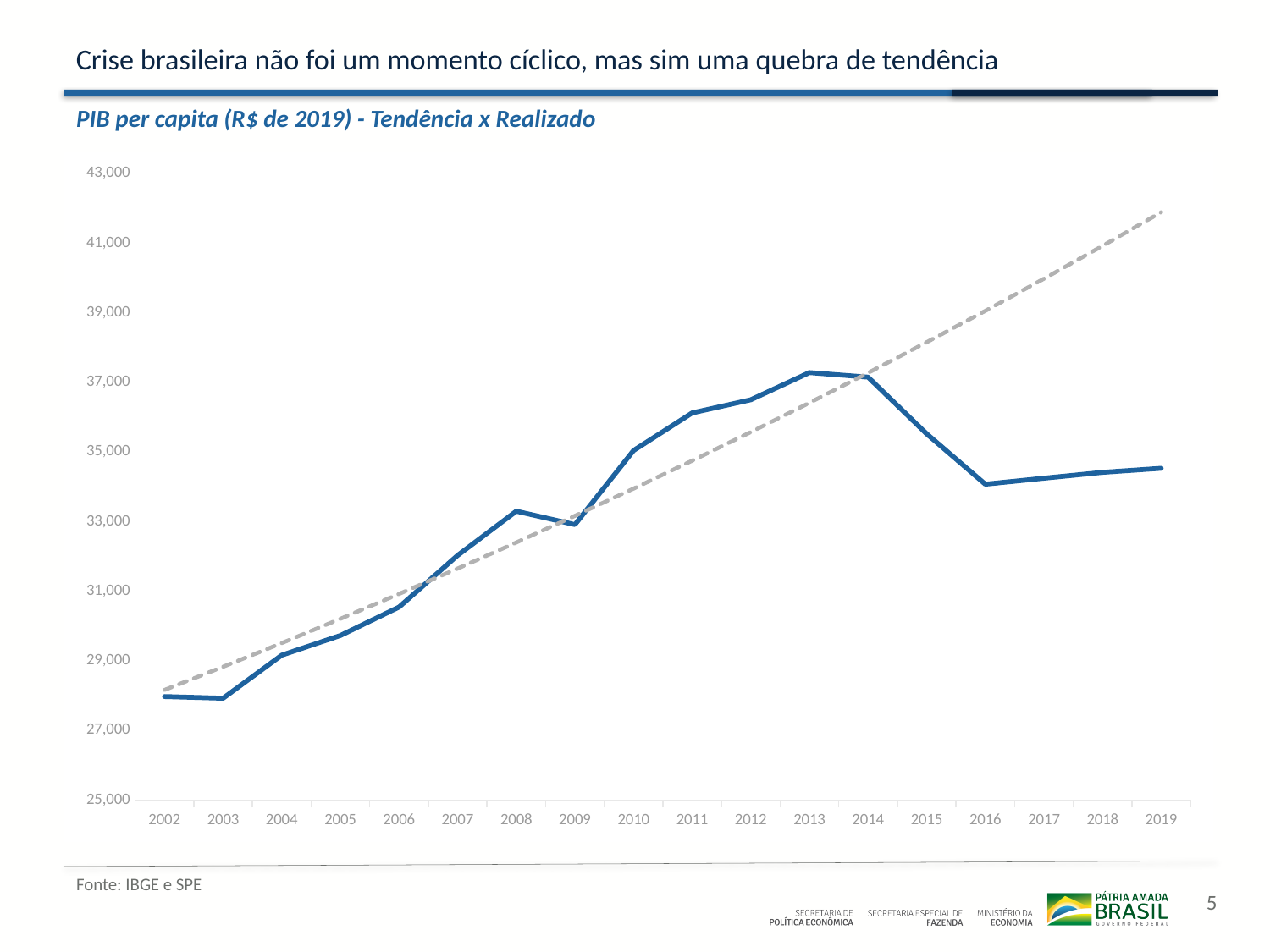
Is the value of the solid blue line in 2016 greater or less than 35,000? less What kind of chart is shown on the slide? line chart Which is larger for the solid blue line: the value in 2013 or the value in 2016? 2013 Is the value of the dashed grey line in 2019 greater or less than 41,000? greater What is the last year shown on the x axis? 2019 In which year does the solid blue line reach its highest value? 2013 How many years are shown on the x axis of the chart? 18 Is the value of the solid blue line in 2002 greater or less than 29,000? less What source is cited below the chart? IBGE e SPE Does the solid blue line rise or fall between 2014 and 2016? fall What is the title of the chart? PIB per capita (R$ de 2019) - Tendência x Realizado What is the first year shown on the x axis? 2002